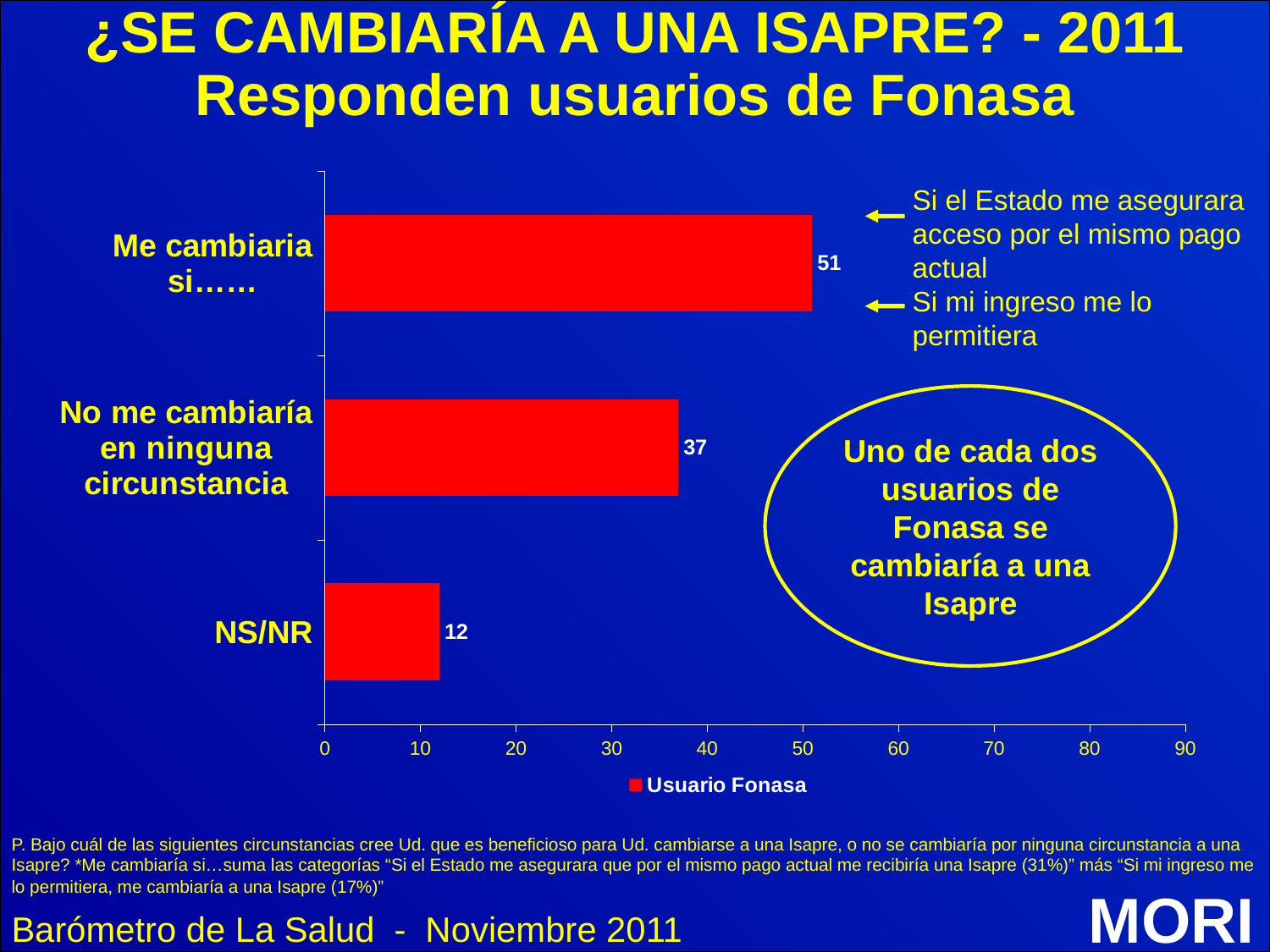
Which is larger, the value for "Me cambiaria si……" or the value for "NS/NR"? Me cambiaria si…… What is the difference between the values for "No me cambiaría en ninguna circunstancia" and "NS/NR"? 25 What kind of chart is shown on the slide? Bar chart What is the value for "NS/NR"? 12 What is the difference between the values for "Me cambiaria si……" and "No me cambiaría en ninguna circunstancia"? 14 What series name does the legend show? Usuario Fonasa What is the value for "Me cambiaria si……"? 51 What is the value for "No me cambiaría en ninguna circunstancia"? 37 How many categories are shown in the chart? 3 Which category has the lowest value? NS/NR Which category has the highest value? Me cambiaria si…… Is the value for "No me cambiaría en ninguna circunstancia" greater or less than 40? less